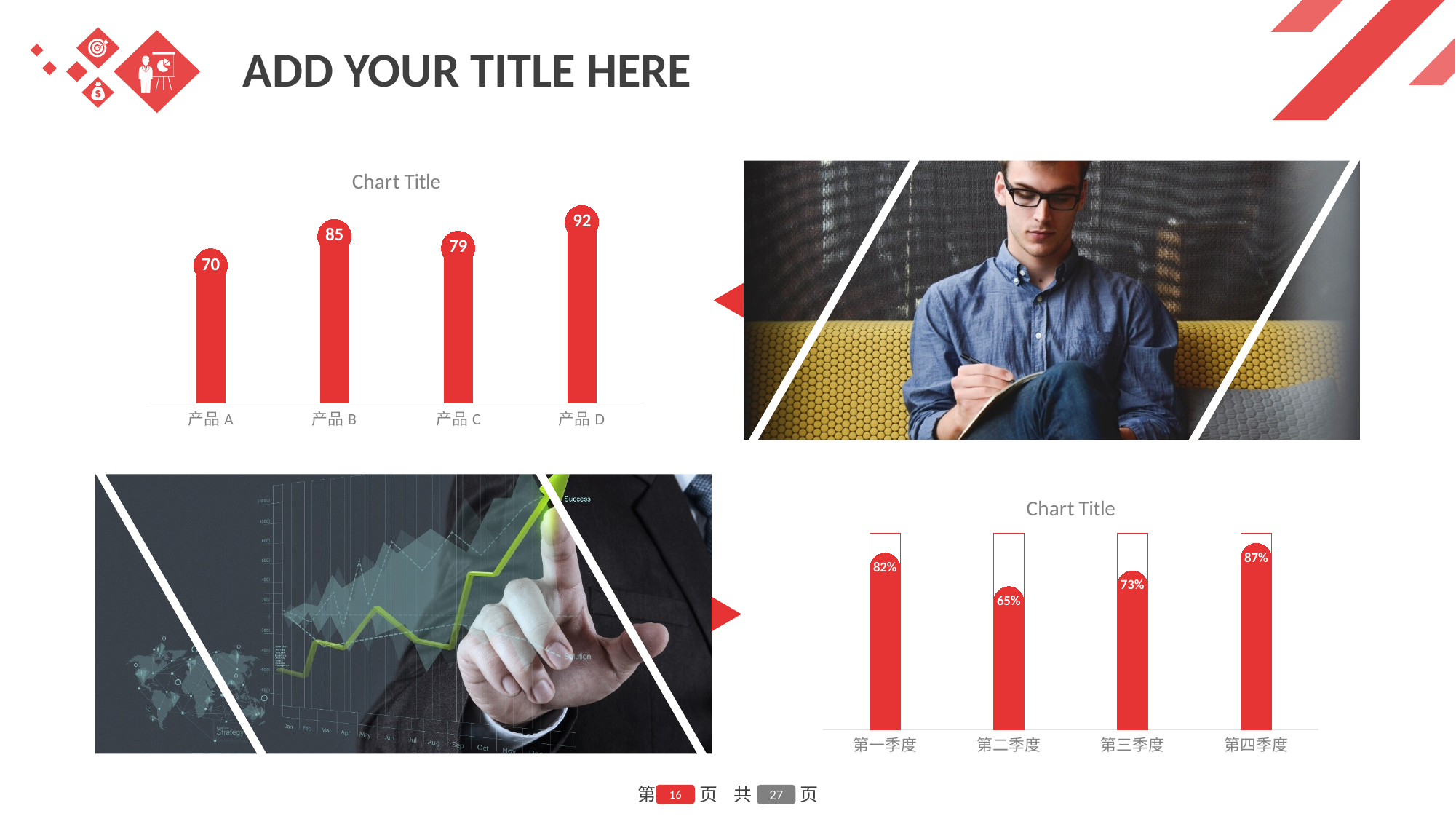
In the top-left chart, which category has the highest value? 产品 D In the bottom-right chart, which category has the highest value? 第四季度 In the bottom-right chart, what is the value for 第二季度? 65% How many categories are shown in the top-left chart? 4 In the bottom-right chart, which category has the lowest value? 第二季度 In the top-left chart, which is larger, the value for 产品 B or 产品 C? 产品 B In the bottom-right chart, what is the difference between the values for 第一季度 and 第三季度? 9% In the top-left chart, which category has the lowest value? 产品 A What kind of chart is the top-left chart? bar chart In the top-left chart, what is the difference between the values for 产品 D and 产品 A? 22 What is the title of the bottom-right chart? Chart Title In the top-left chart, what is the value for 产品 B? 85